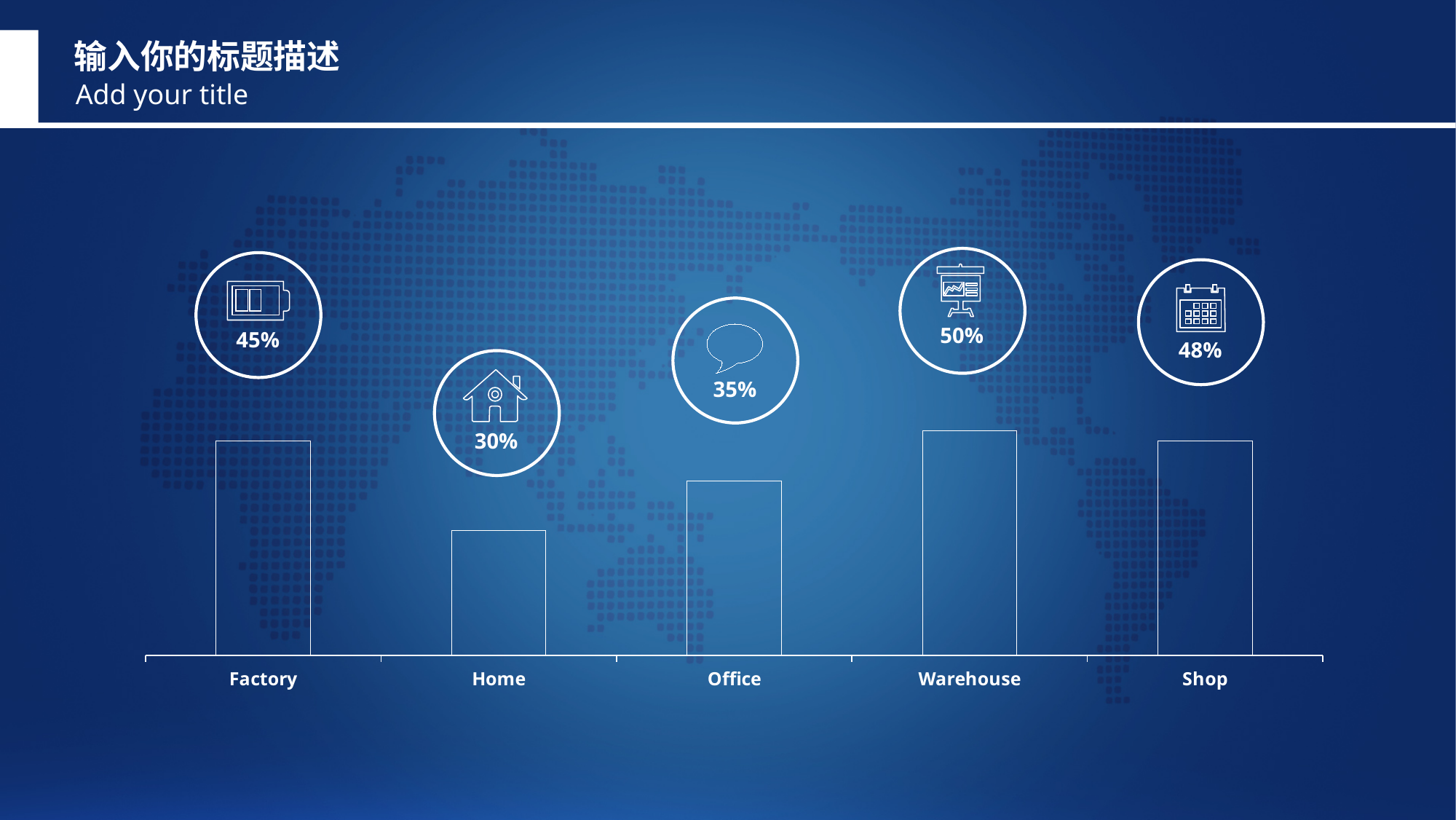
What is the value for Warehouse? 50% What kind of chart is shown on the slide? Bar chart What is the value for Shop? 48% Which is larger, the value for Shop or the value for Factory? Shop What is the difference between the values for Warehouse and Home? 20% Which category has the highest value? Warehouse What is the value for Office? 35% How many categories are shown in the chart? 5 What is the difference between the values for Factory and Office? 10% What is the value for Factory? 45% Which category has the lowest value? Home What is the value for Home? 30%